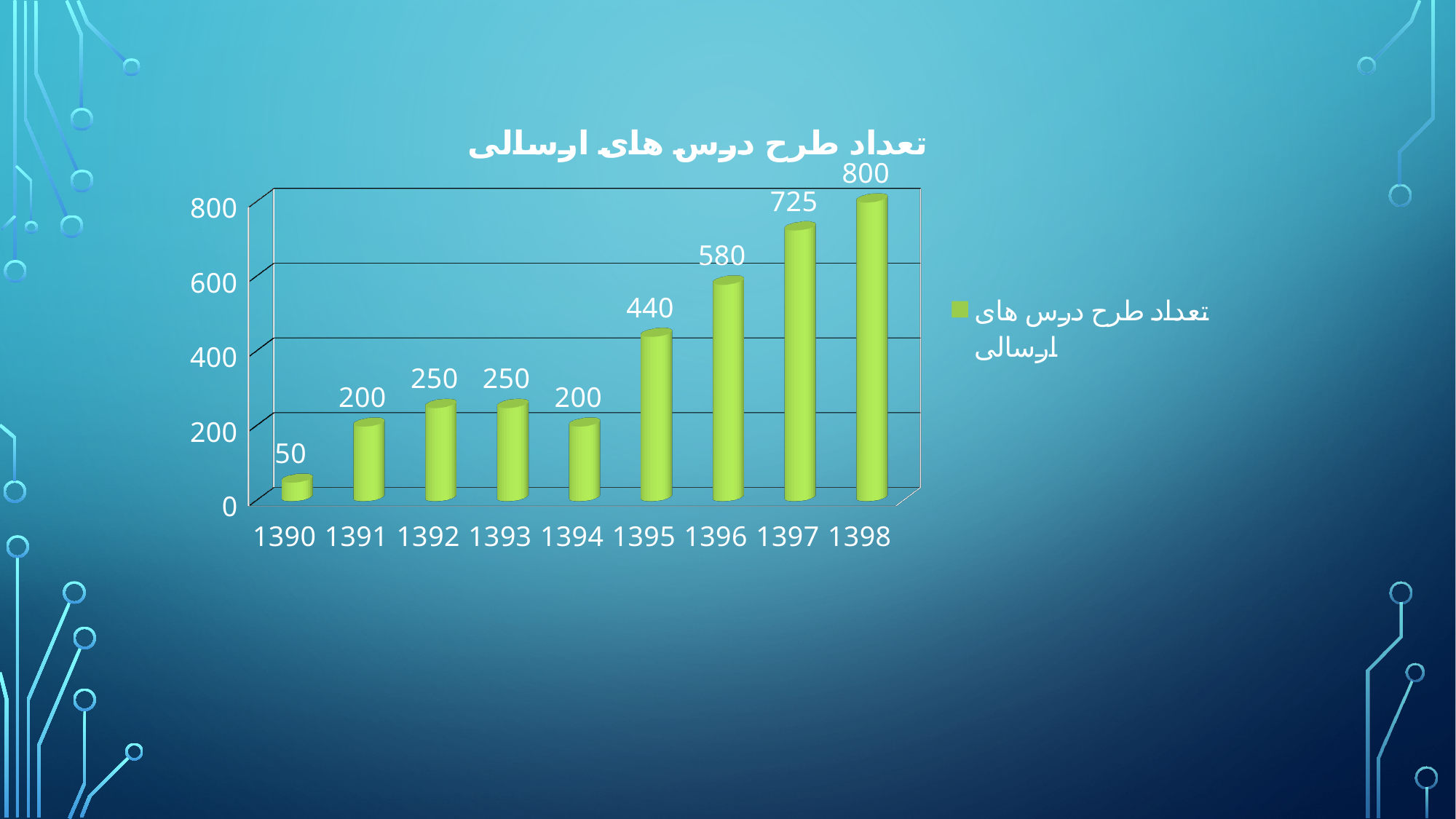
Which year has the lowest value? 1390 What is the value for 1397? 725 What is the difference between the values for 1395 and 1394? 240 What is the value for 1395? 440 What kind of chart is shown on the slide? bar chart How many series does the legend list? 1 What is the value for 1390? 50 How many years are shown on the x axis? 9 Which year has the highest value? 1398 Is the value for 1397 greater or less than 600? greater What is the difference between the values for 1398 and 1396? 220 Which is larger, the value for 1396 or the value for 1393? 1396